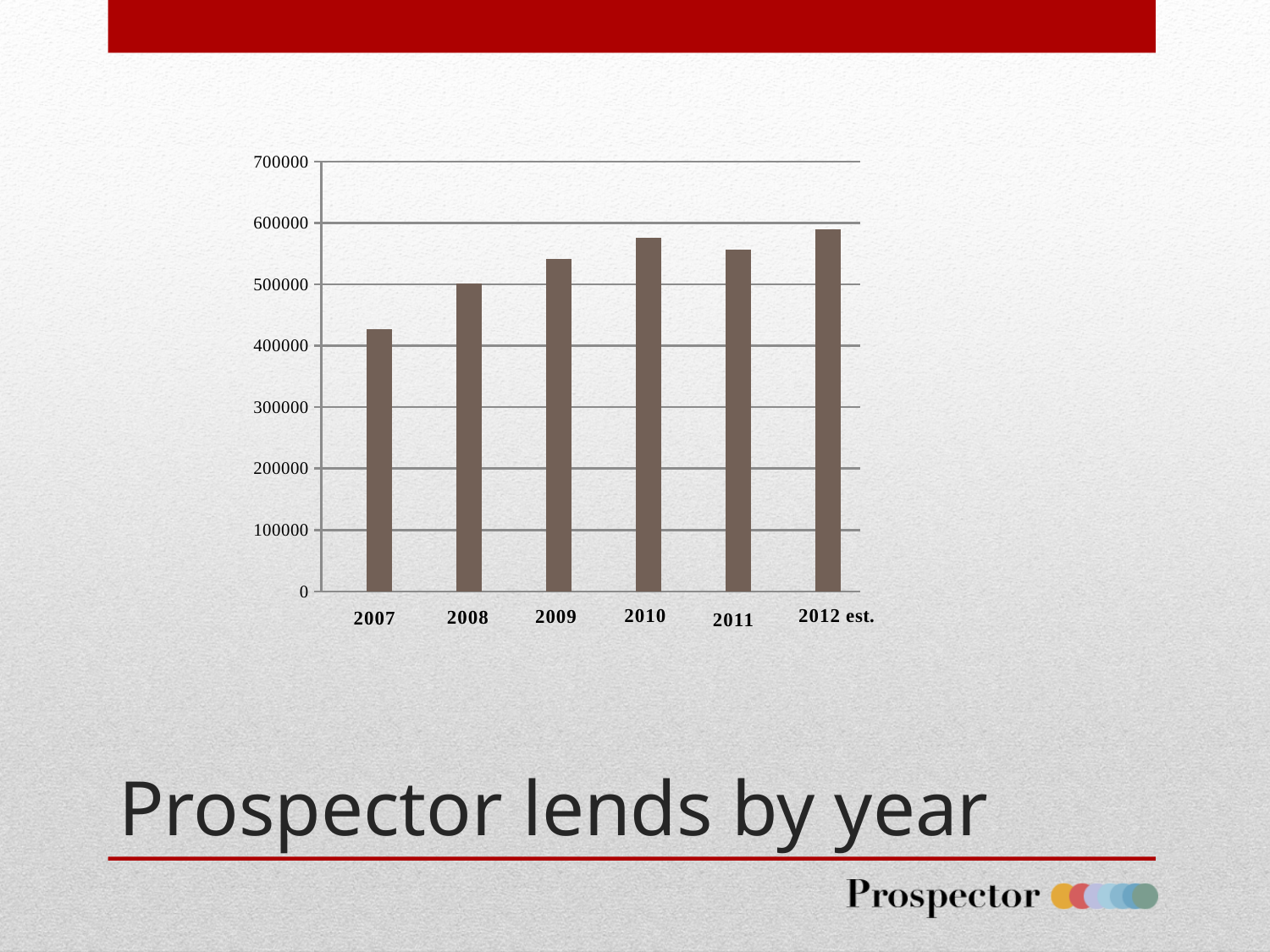
Do the values generally rise or fall from 2007 to 2012 est.? rise What kind of chart is shown on the slide? bar chart Which year has the highest number of lends? 2012 est. What is the title of the slide containing the chart? Prospector lends by year Is the value for 2007 greater or less than 400000? greater Is the value for 2011 greater or less than 500000? greater How many years (bars) are shown on the chart? 6 Is the value for 2009 greater or less than 500000? greater Which year has the lowest number of lends? 2007 Which year has the larger value, 2010 or 2011? 2010